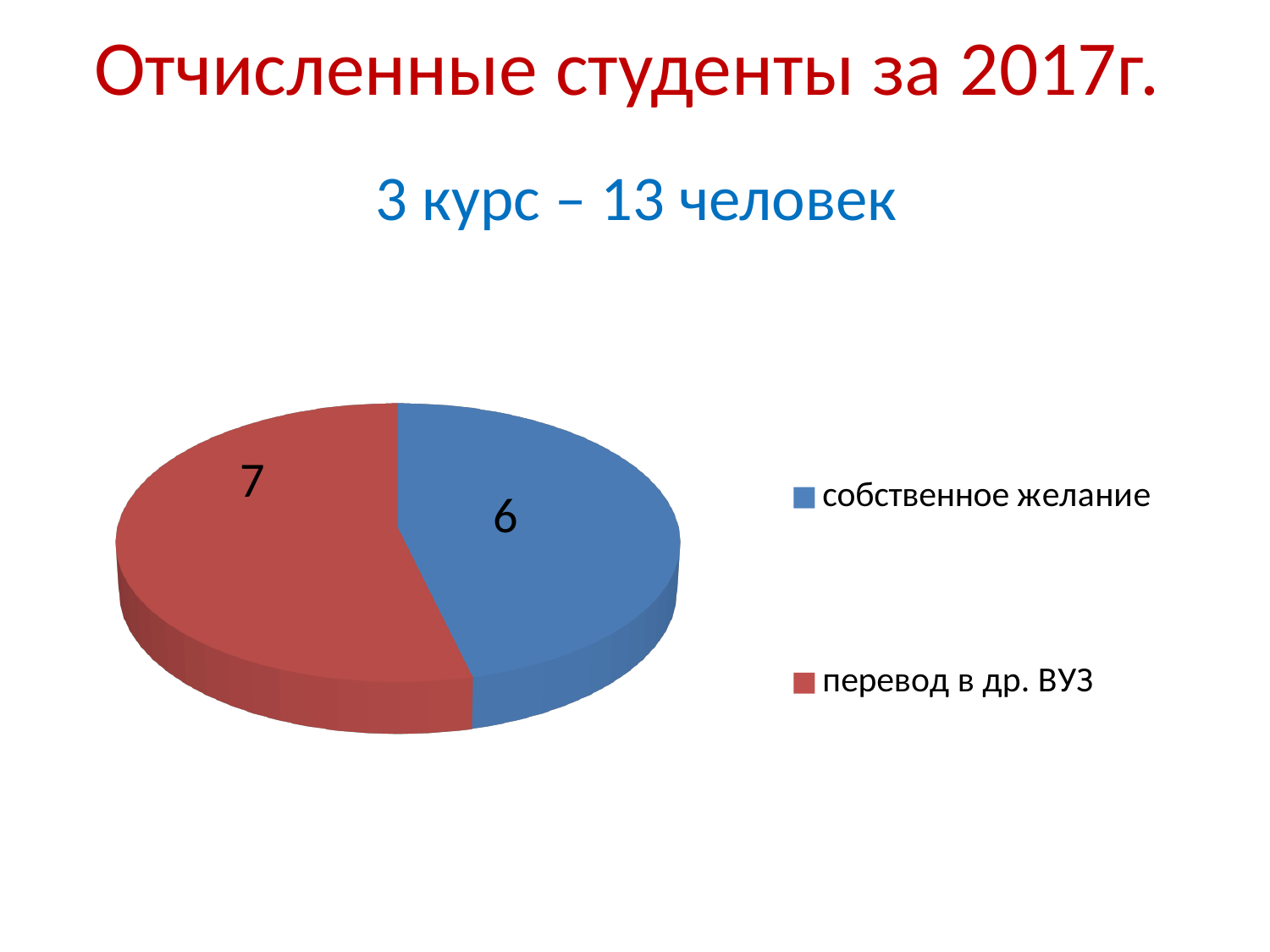
How many slices does the pie chart have? 2 What is the difference between the values for "перевод в др. ВУЗ" and "собственное желание"? 1 Which category has the smallest slice? собственное желание What kind of chart is shown on the slide? pie chart What is the subtitle above the chart? 3 курс – 13 человек What is the value for "собственное желание"? 6 What colour is the slice for "собственное желание"? blue Which is larger: "собственное желание" or "перевод в др. ВУЗ"? перевод в др. ВУЗ What is the value for "перевод в др. ВУЗ"? 7 What is the total of all slices in the pie chart? 13 Which category has the largest slice? перевод в др. ВУЗ